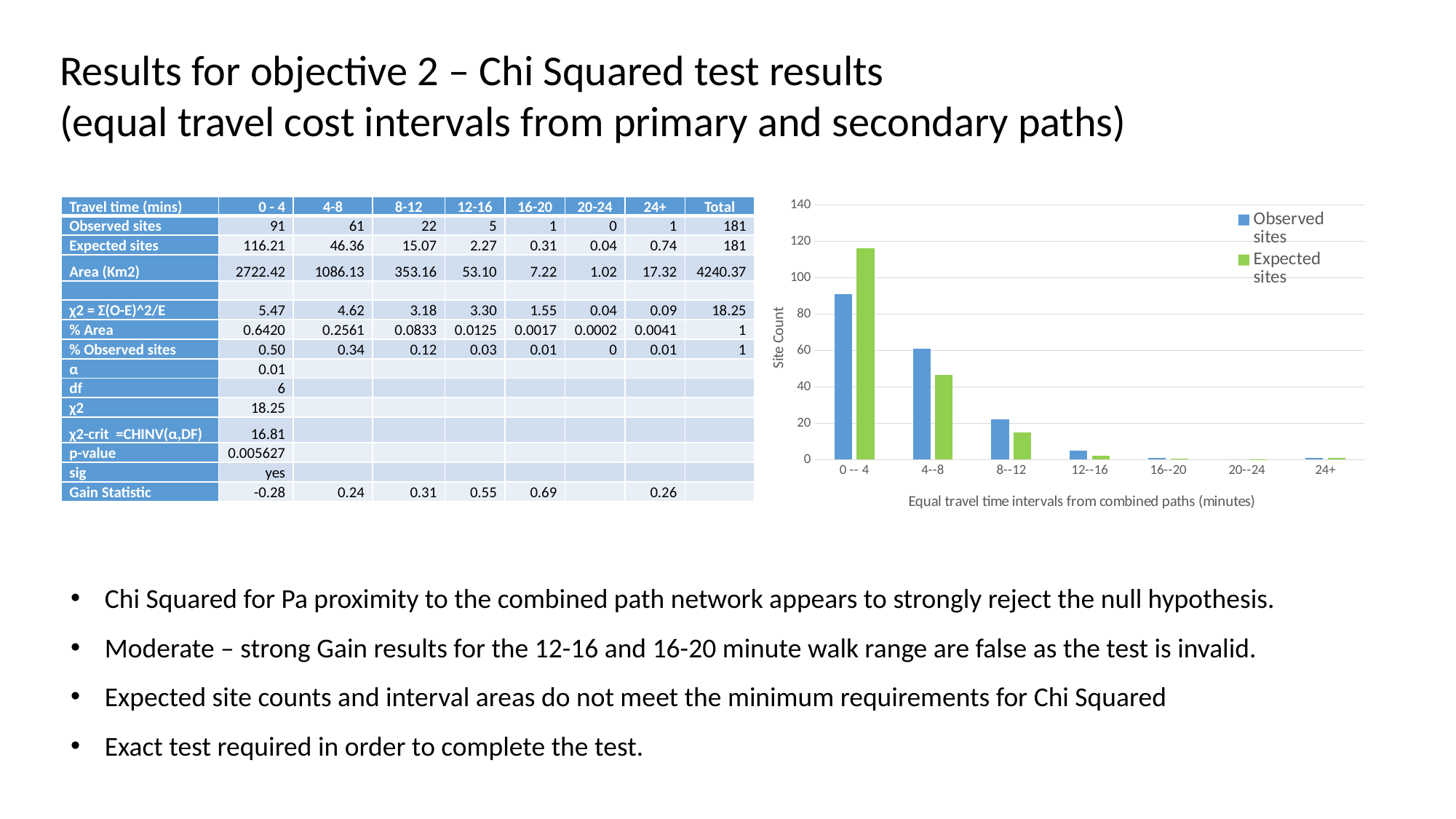
Which travel time interval has the highest Observed sites bar? 0 -- 4 How many travel time interval categories are shown on the chart's x axis? 7 Is the Observed sites value for 0 -- 4 greater or less than 80? greater For the 0 -- 4 interval, which is larger: Observed sites or Expected sites? Expected sites What kind of chart is shown on the slide? bar chart What is the title of the chart's x axis? Equal travel time intervals from combined paths (minutes) Is the Expected sites value for 4--8 greater or less than 60? less Is the Expected sites value for 0 -- 4 greater or less than 100? greater How many series does the chart's legend list? 2 Do the Observed sites values rise or fall as travel time increases along the x axis? fall For the 4--8 interval, which is larger: Observed sites or Expected sites? Observed sites What is the title of the chart's y axis? Site Count